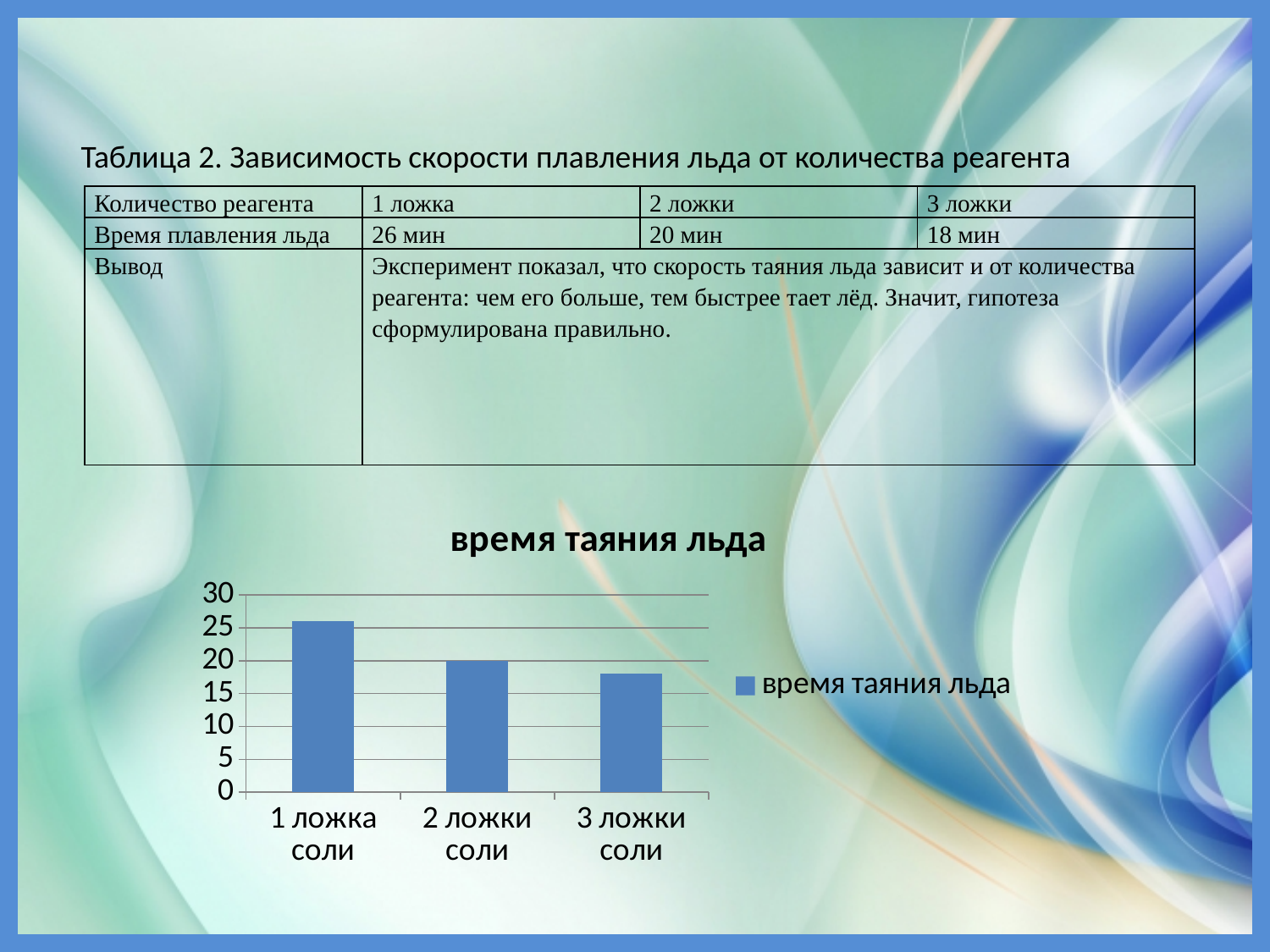
Is the value for 3 ложки соли greater or less than 20? less Is the value for 1 ложка соли greater or less than 25? greater According to the table on the slide, what is the ice melting time for 1 ложка of reagent? 26 мин How many series does the chart legend list? 1 Which is larger, the value for 1 ложка соли or the value for 2 ложки соли? 1 ложка соли How many categories are shown on the x axis of the chart? 3 Which category has the lowest bar in the chart? 3 ложки соли Which category has the highest bar in the chart? 1 ложка соли What is the title of the chart? время таяния льда According to the table on the slide, what is the ice melting time for 3 ложки of reagent? 18 мин Do the values rise or fall from left to right along the x axis? fall What kind of chart is shown on the slide? bar chart